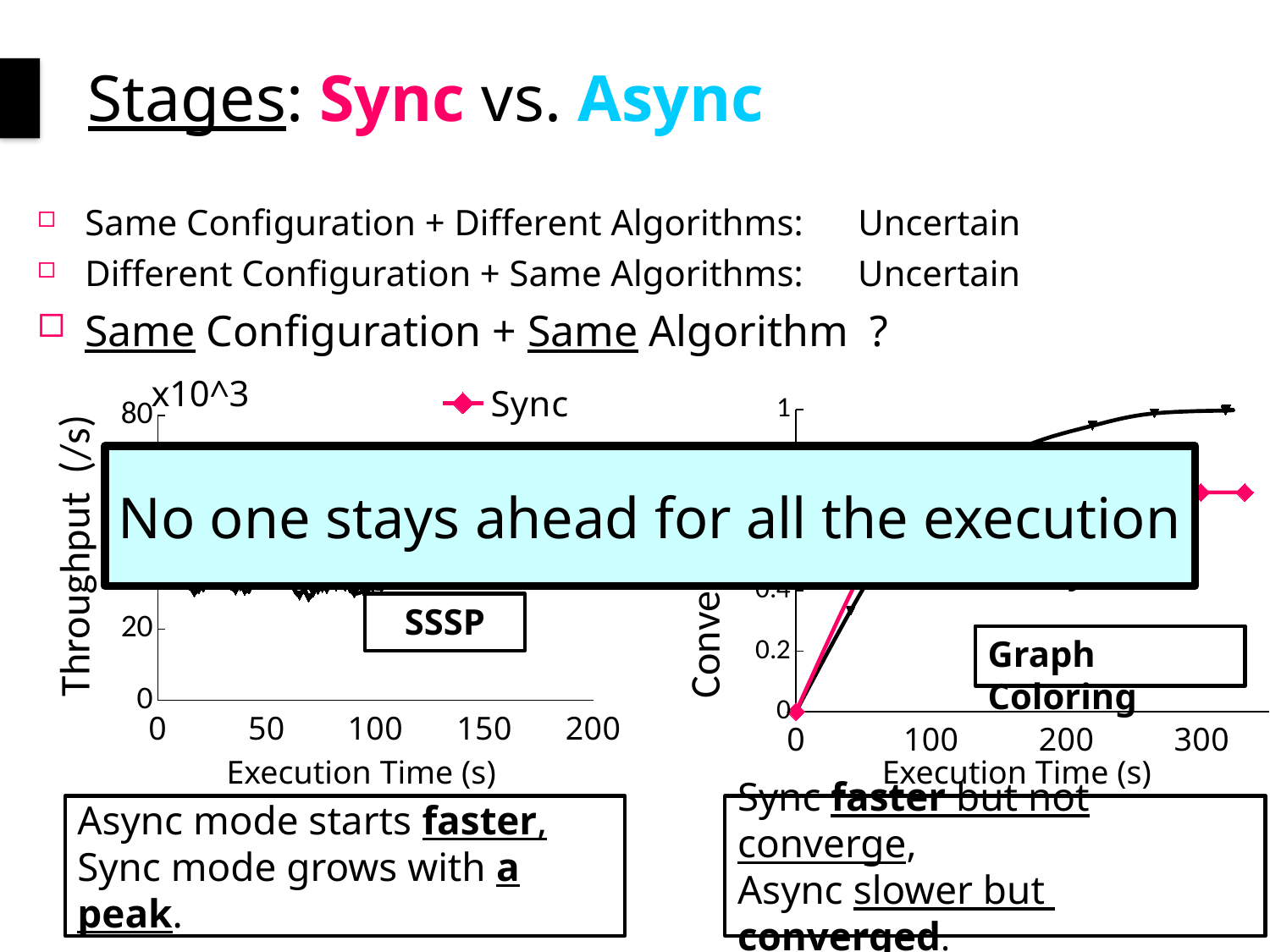
What kind of chart is the SSSP chart on the left of the slide? line chart In the SSSP chart on the left, is the value of the black series at 50 s greater or less than 40? less In the Graph Coloring chart on the right, is the value of the black series at 300 s greater or less than 0.8? greater What kind of chart is the Graph Coloring chart on the right of the slide? line chart In the Graph Coloring chart on the right, does the black series rise or fall as execution time increases from 0 to 300 s? rise In the SSSP chart on the left, which series name is shown in the legend with a pink diamond marker? Sync In the SSSP chart on the left, what is the label of the x axis? Execution Time (s)